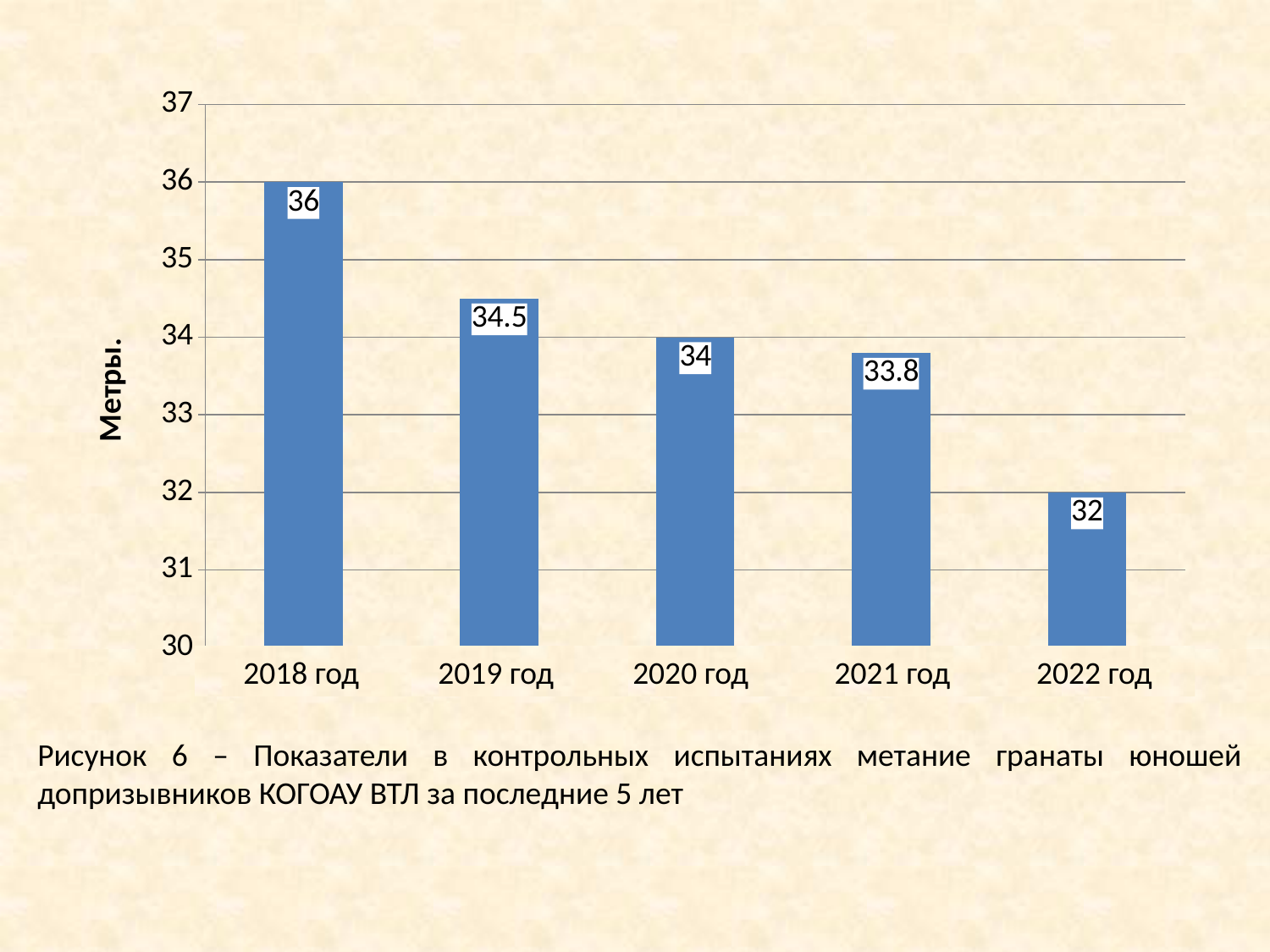
What kind of chart is this? bar chart Which is larger, the value for 2020 год or the value for 2021 год? 2020 год Which year has the highest value? 2018 год Which year has the lowest value? 2022 год Do the values rise or fall from 2018 год to 2022 год? fall What is the difference between the values for 2018 год and 2022 год? 4 What is the value for 2019 год? 34.5 How many years are shown on the chart? 5 What is the value for 2018 год? 36 What is the difference between the values for 2019 год and 2020 год? 0.5 What is the value for 2022 год? 32 What is the value for 2021 год? 33.8